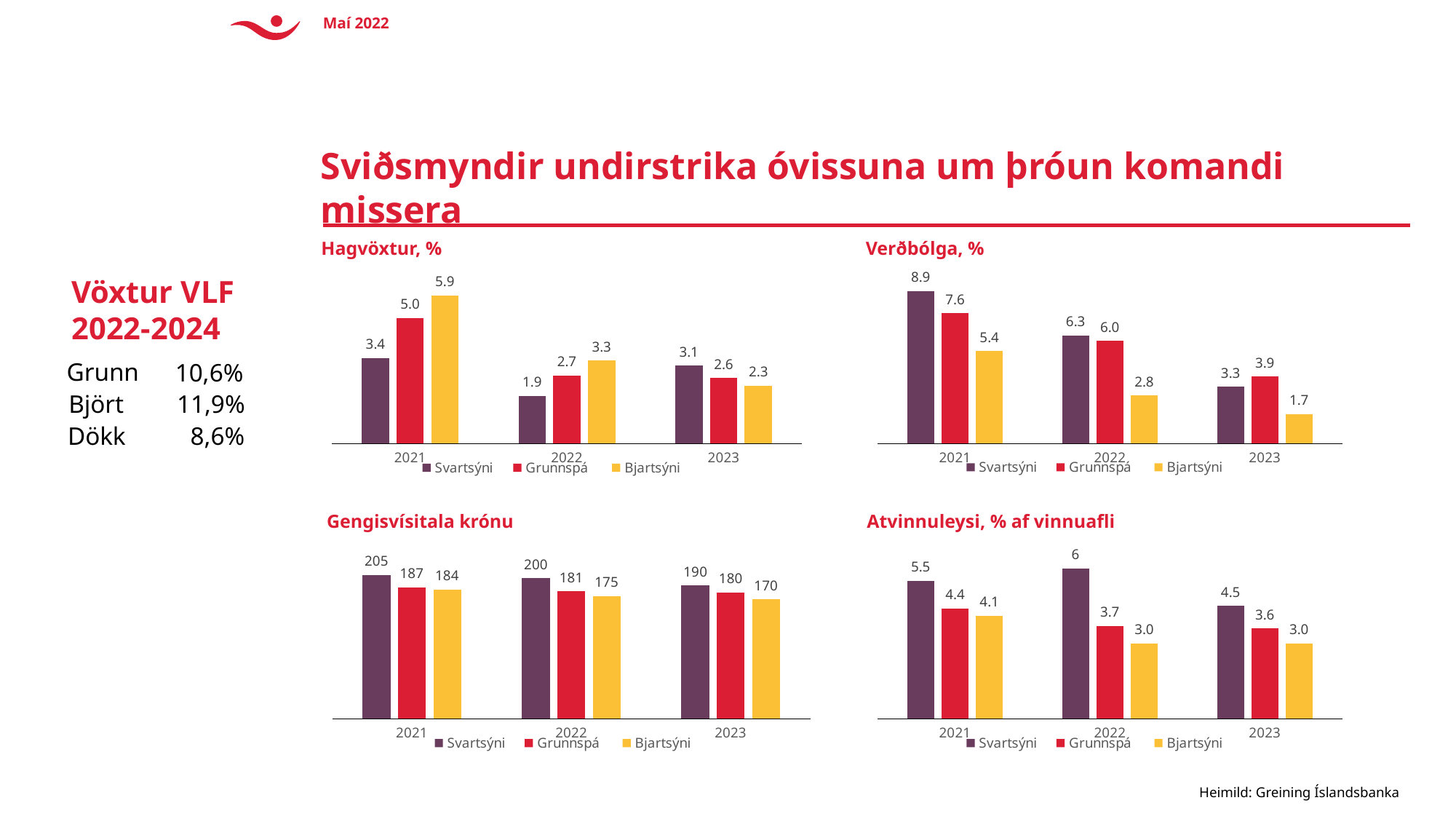
In the 'Verðbólga, %' chart, do the Grunnspá values rise or fall from 2021 to 2023? fall What kind of chart is the 'Atvinnuleysi, % af vinnuafli' chart? bar chart In the 'Gengisvísitala krónu' chart, what is the value for Grunnspá in 2022? 181 How many series does the legend of the 'Verðbólga, %' chart list? 3 In the 'Verðbólga, %' chart, which series has the lowest value in 2023? Bjartsýni How many years are shown on the x axis of the 'Gengisvísitala krónu' chart? 3 In the 'Hagvöxtur, %' chart, which series has the highest value in 2022? Bjartsýni In the 'Atvinnuleysi, % af vinnuafli' chart, what is the value for Svartsýni in 2022? 6 In the 'Atvinnuleysi, % af vinnuafli' chart, is the Grunnspá value in 2021 larger or smaller than the Grunnspá value in 2023? larger In the 'Gengisvísitala krónu' chart, what is the difference between the Svartsýni and Bjartsýni values in 2021? 21 In the 'Hagvöxtur, %' chart, what is the value for Bjartsýni in 2021? 5.9 In the 'Verðbólga, %' chart, what is the value for Svartsýni in 2021? 8.9